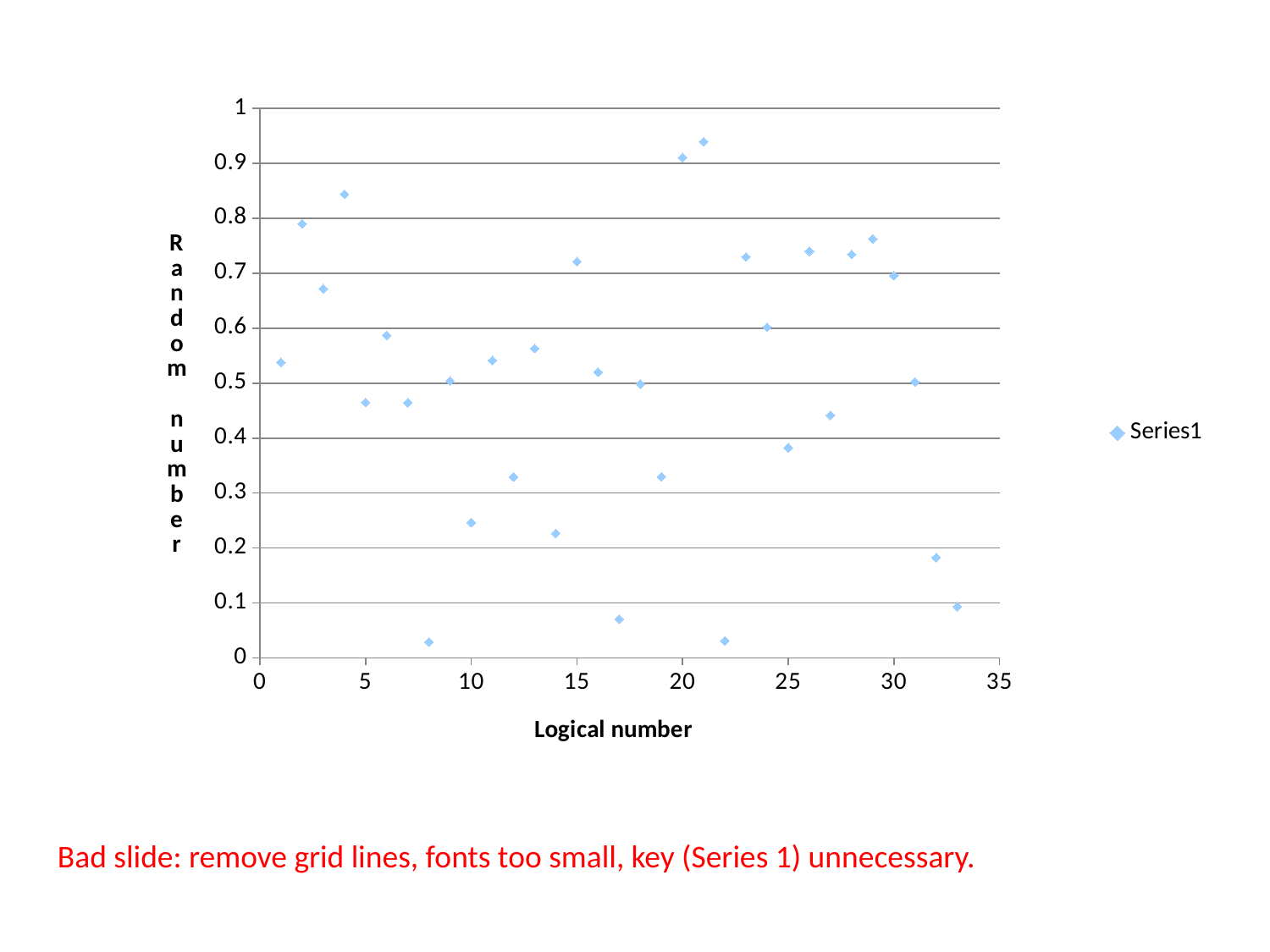
Is the random number at logical number 10 greater or less than 0.3? less How many data points are plotted on the chart? 33 Is the random number at logical number 8 greater or less than 0.1? less Which has the larger random number, logical number 2 or logical number 3? logical number 2 How many series does the legend list? 1 At which logical number is the random number highest? 21 Is the random number at logical number 4 greater or less than 0.8? greater What kind of chart is shown on the slide? scatter chart What is the title of the x axis? Logical number Which has the larger random number, logical number 16 or logical number 17? logical number 16